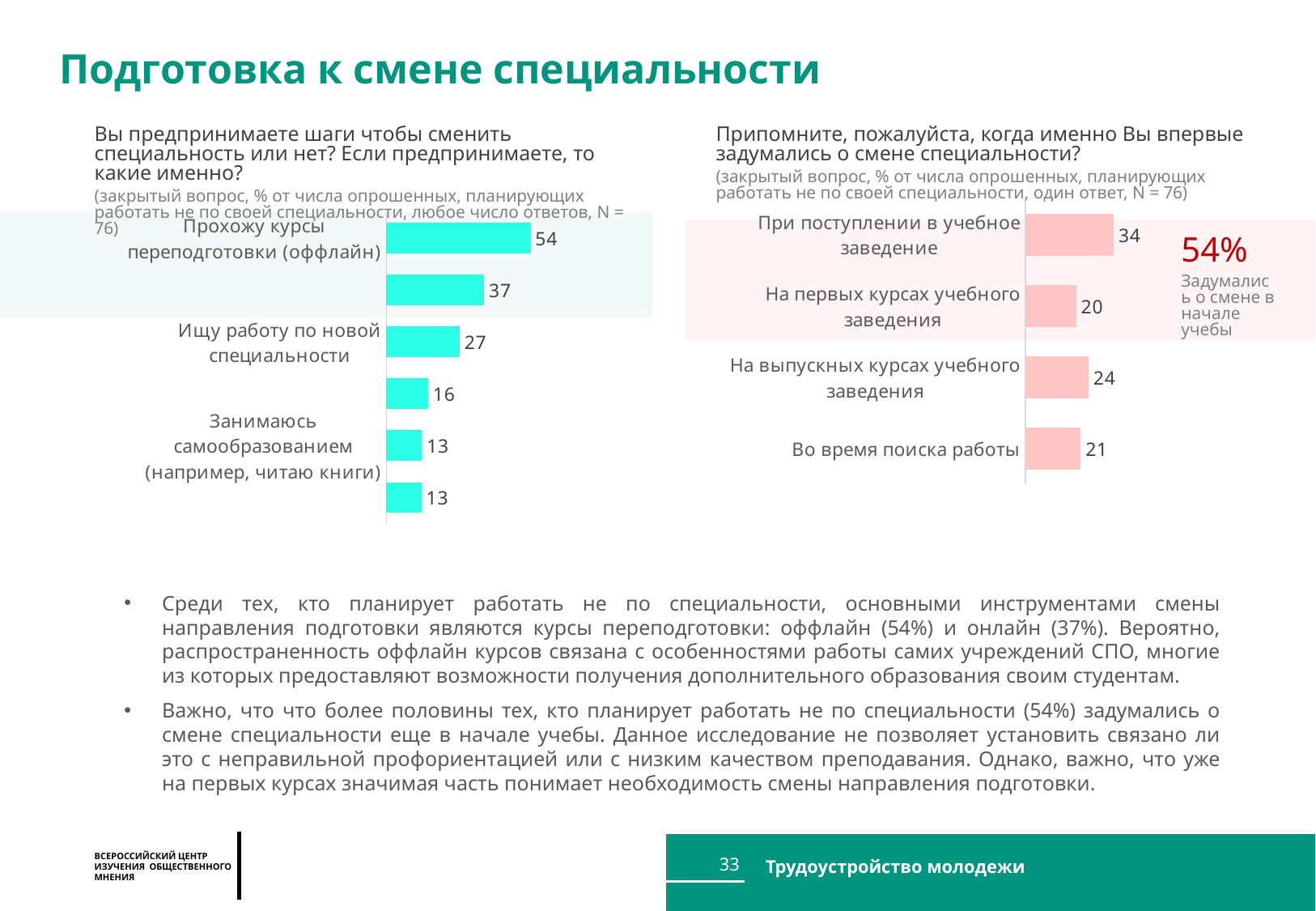
In the right chart, which is larger: «На выпускных курсах учебного заведения» or «На первых курсах учебного заведения»? На выпускных курсах учебного заведения In the left chart (Вы предпринимаете шаги чтобы сменить специальность или нет?), what is the value for «Прохожу курсы переподготовки (оффлайн)»? 54 What type of chart is the right chart? Bar chart In the left chart, what is the difference between «Прохожу курсы переподготовки (оффлайн)» and «Ищу работу по новой специальности»? 27 In the right chart, what is the value for «Во время поиска работы»? 21 In the right chart, which category has the highest value? При поступлении в учебное заведение In the right chart, which category has the lowest value? На первых курсах учебного заведения In the right chart (Припомните, пожалуйста, когда именно Вы впервые задумались о смене специальности?), what is the value for «При поступлении в учебное заведение»? 34 In the left chart, what is the highest value shown on any bar? 54 In the left chart, what is the value for «Ищу работу по новой специальности»? 27 In the left chart, what is the value for «Занимаюсь самообразованием (например, читаю книги)»? 13 In the left chart, how many bars are plotted? 6